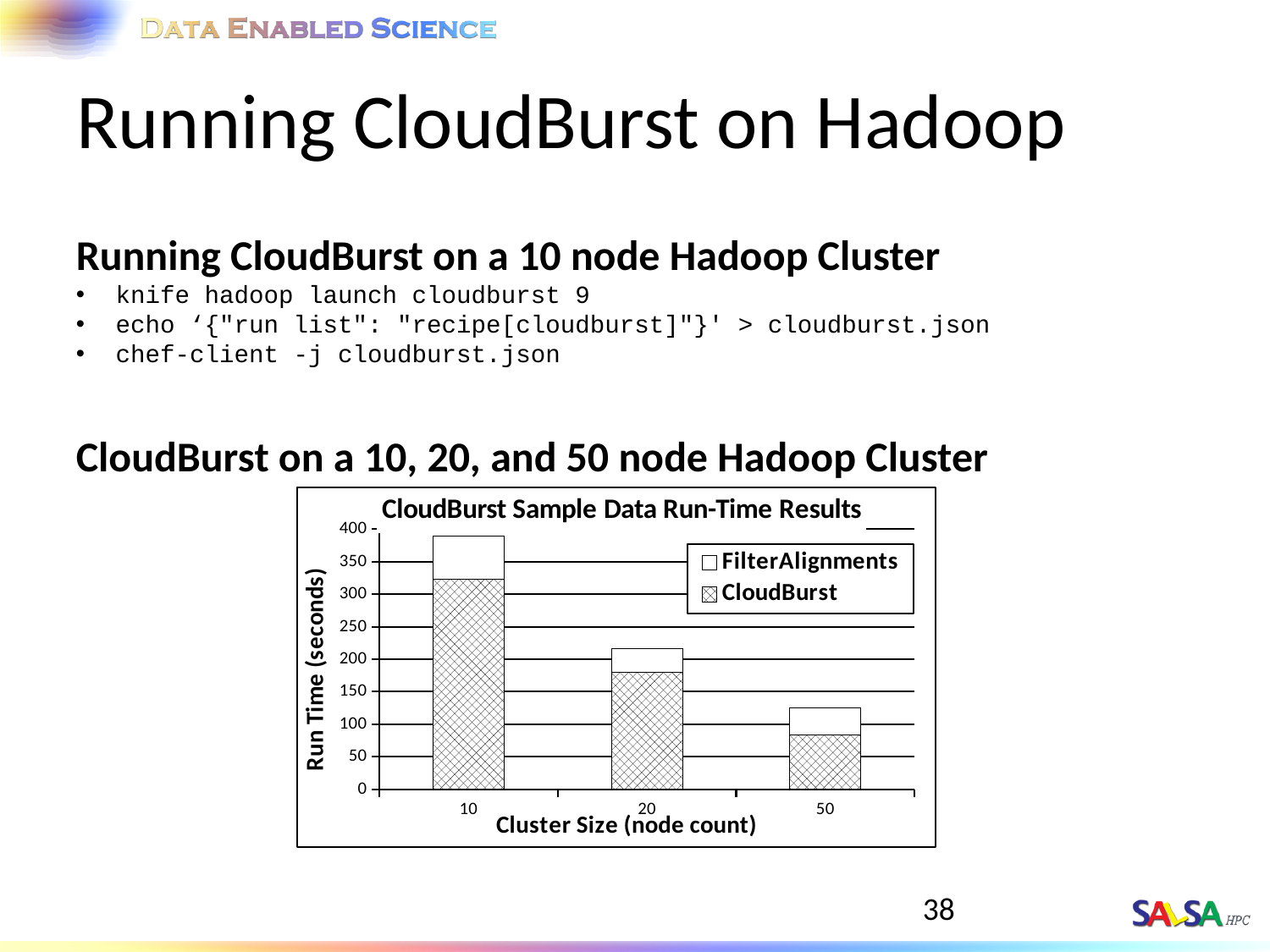
How many series does the chart legend list? 2 Which cluster size has the highest total run time? 10 Which cluster size has the lowest total run time? 50 What kind of chart is shown on the slide? bar chart Is the CloudBurst run time for the 50 node cluster greater or less than 100 seconds? less What is the label of the y axis? Run Time (seconds) What is the title of the chart? CloudBurst Sample Data Run-Time Results Is the CloudBurst run time for the 20 node cluster greater or less than 150 seconds? greater Do the total run times rise or fall as cluster size increases along the x axis? fall How many cluster sizes are plotted on the x axis? 3 Is the CloudBurst run time larger for the 20 node cluster or the 50 node cluster? 20 node cluster Is the CloudBurst run time for the 10 node cluster greater or less than 300 seconds? greater